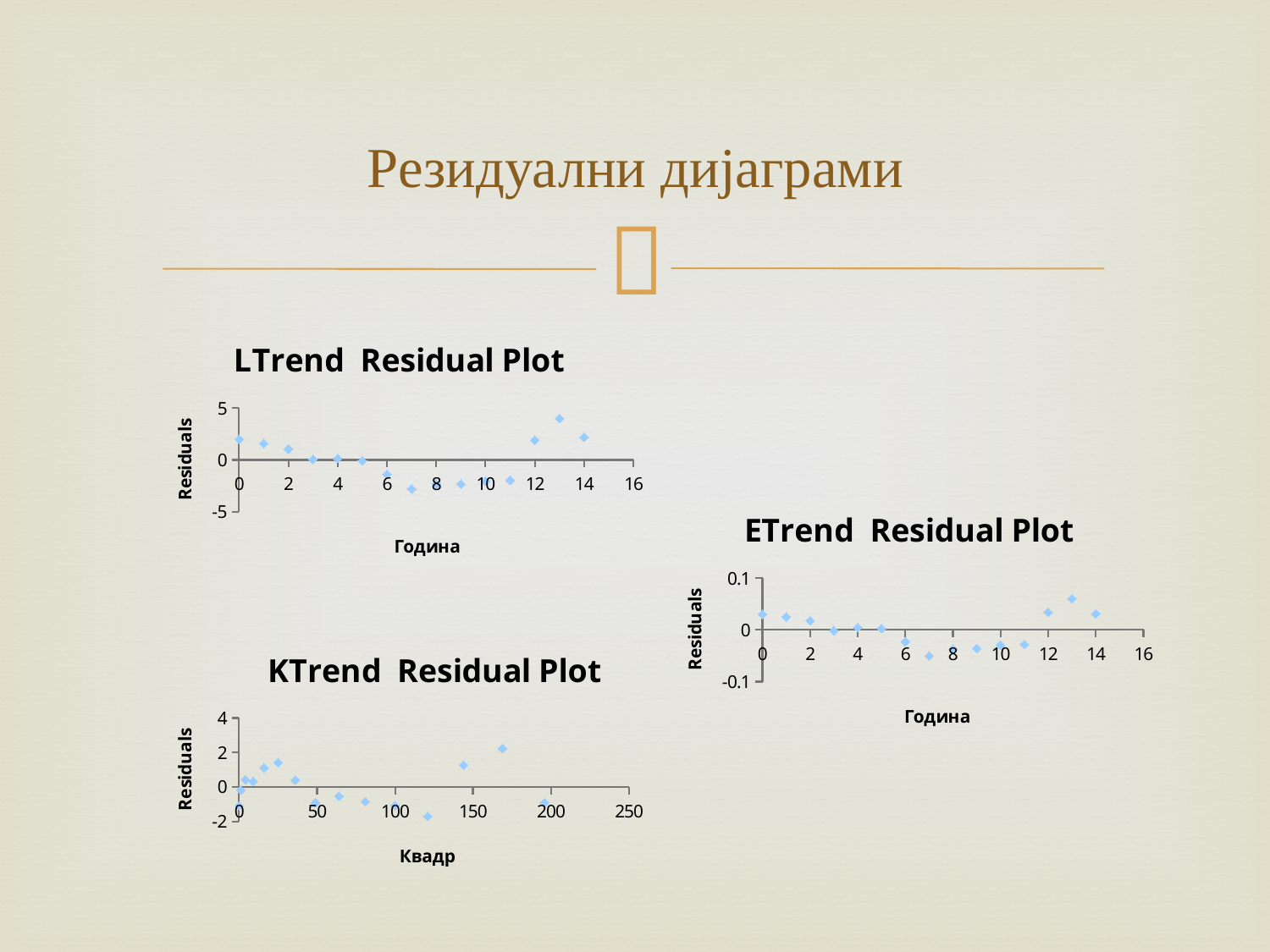
How many charts are shown on the slide? 3 What is the x-axis title of the KTrend Residual Plot? Квадр In the ETrend Residual Plot, is the residual at year 8 greater or less than 0? less In the LTrend Residual Plot, at which year is the residual highest? 13 In the ETrend Residual Plot, which residual is larger: the one at year 0 or the one at year 6? year 0 What kind of chart is the LTrend Residual Plot? scatter plot In the LTrend Residual Plot, is the residual at year 13 greater or less than 0? greater In the LTrend Residual Plot, is the residual at year 7 greater or less than 0? less In the ETrend Residual Plot, at which year is the residual highest? 13 In the KTrend Residual Plot, what is the highest value shown on the x axis? 250 In the LTrend Residual Plot, how many data points are plotted? 15